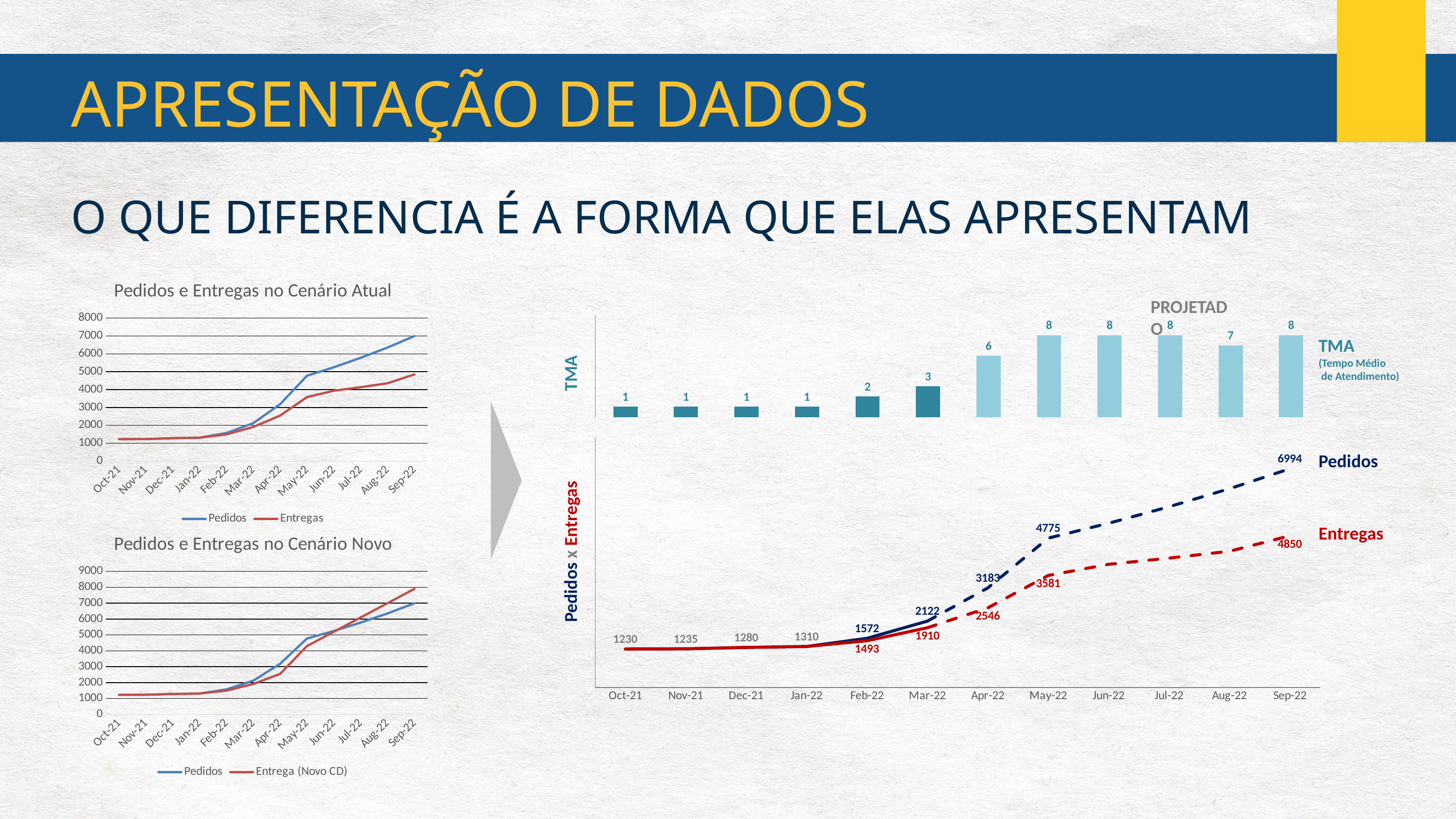
In the TMA bar chart on the right, what is the TMA value for Mar-22? 3 In the Pedidos x Entregas chart on the right, what is the Entregas value for Apr-22? 2546 What kind of chart is 'Pedidos e Entregas no Cenário Atual'? line chart In the 'Pedidos e Entregas no Cenário Novo' chart, is the value of Entrega (Novo CD) in Sep-22 greater or less than 7000? greater In the Pedidos x Entregas chart on the right, what is the difference between Pedidos and Entregas in Sep-22? 2144 In the Pedidos x Entregas chart on the right, what is the Pedidos value for May-22? 4775 How many series does the legend of 'Pedidos e Entregas no Cenário Novo' list? 2 In the TMA bar chart on the right, which month has the lowest TMA value among Feb-22, Mar-22 and Apr-22? Feb-22 In the TMA bar chart on the right, what is the TMA value for Aug-22? 7 In the TMA bar chart on the right, how many bars (months) are plotted? 12 In the Pedidos x Entregas chart on the right, do the Pedidos values rise or fall from Oct-21 to Sep-22? rise In the Pedidos x Entregas chart on the right, which is larger in Mar-22: Pedidos or Entregas? Pedidos